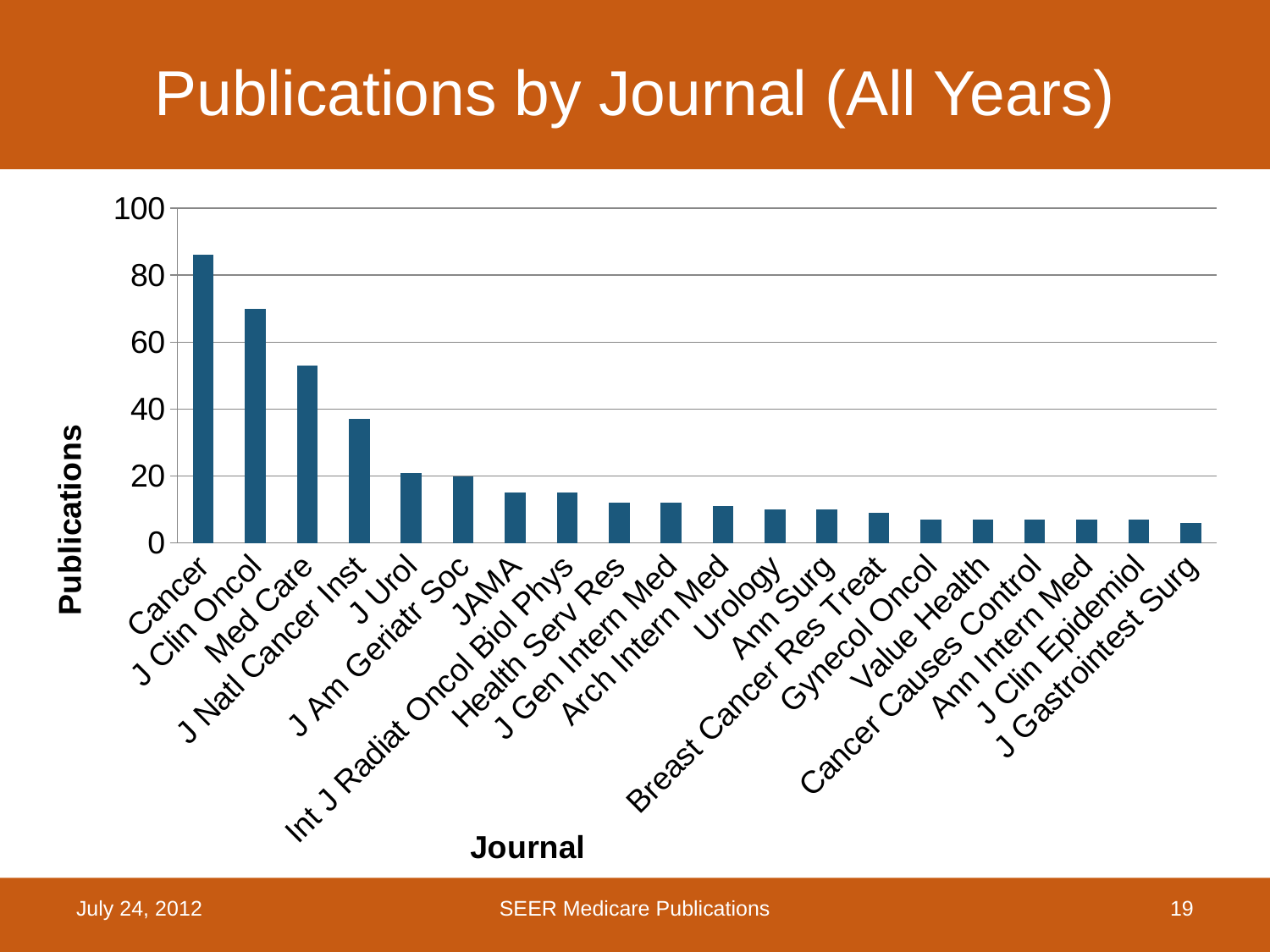
Is the value for J Clin Oncol greater or less than 60? greater Which has more publications, Med Care or J Urol? Med Care Is the value for JAMA greater or less than 20? less Is the value for J Natl Cancer Inst greater or less than 40? less Which journal has the highest number of publications? Cancer How many journals are shown on the x axis? 20 What is the title of the chart's vertical axis? Publications Do the values rise or fall moving from left to right along the x axis? fall Which has more publications, Cancer or J Clin Oncol? Cancer What kind of chart is shown on the slide? bar chart